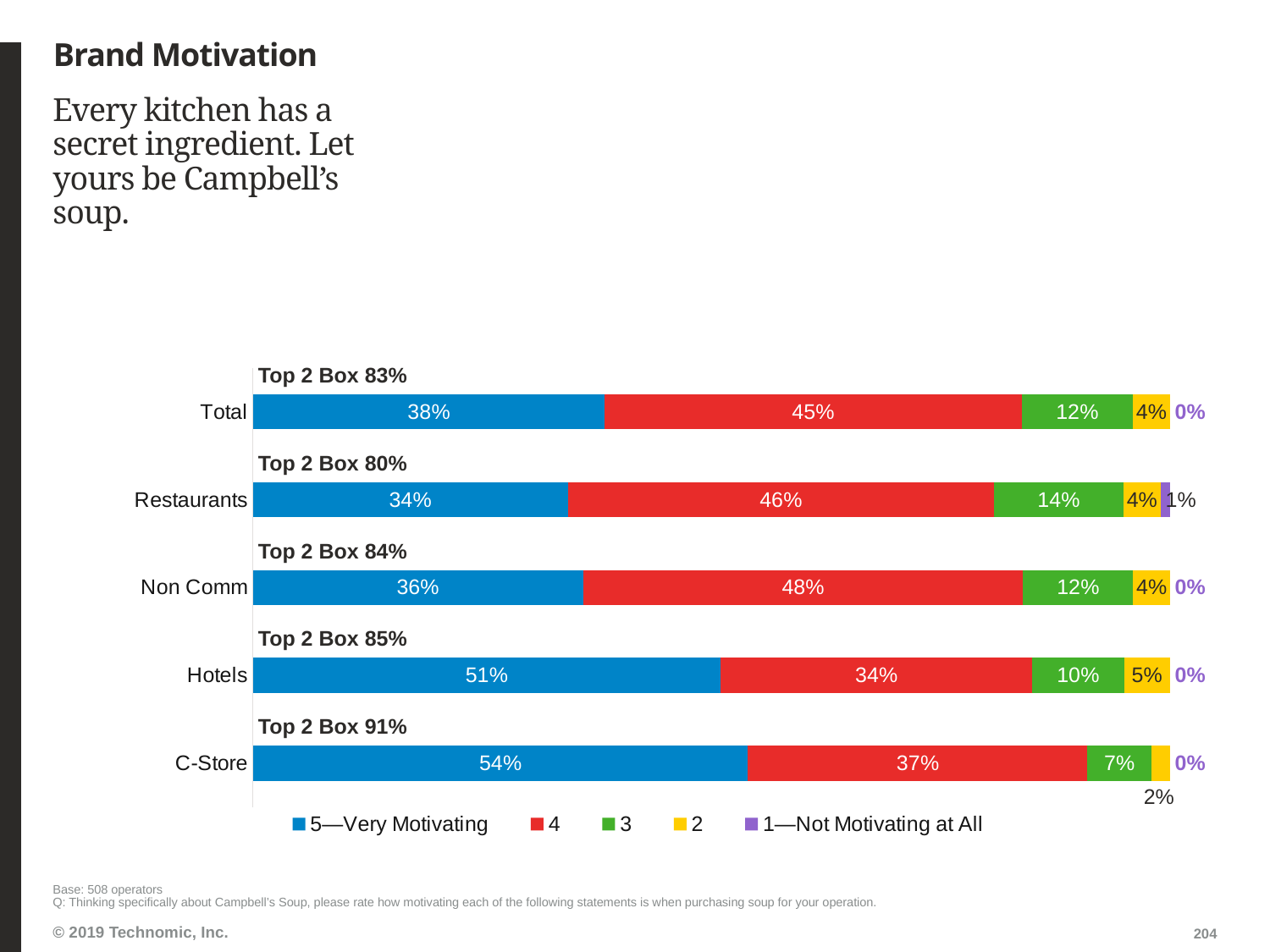
How many categories are shown on the chart? 5 What is the difference between the 5—Very Motivating values for C-Store and Total? 16 percentage points What percentage of Hotels operators rated the statement 5—Very Motivating? 51% Which category has the lowest Top 2 Box value? Restaurants Which is larger: the '3' rating share for Restaurants or for Hotels? Restaurants What is the value of the '4' segment for Non Comm? 48% What type of chart is shown on the slide? Stacked bar chart Which category has the highest share of 5—Very Motivating ratings? C-Store What percentage of Restaurants operators gave a rating of 1—Not Motivating at All? 1% How many series does the legend list? 5 What colour represents the '4' rating in the chart? Red What is the Top 2 Box value shown for C-Store? 91%